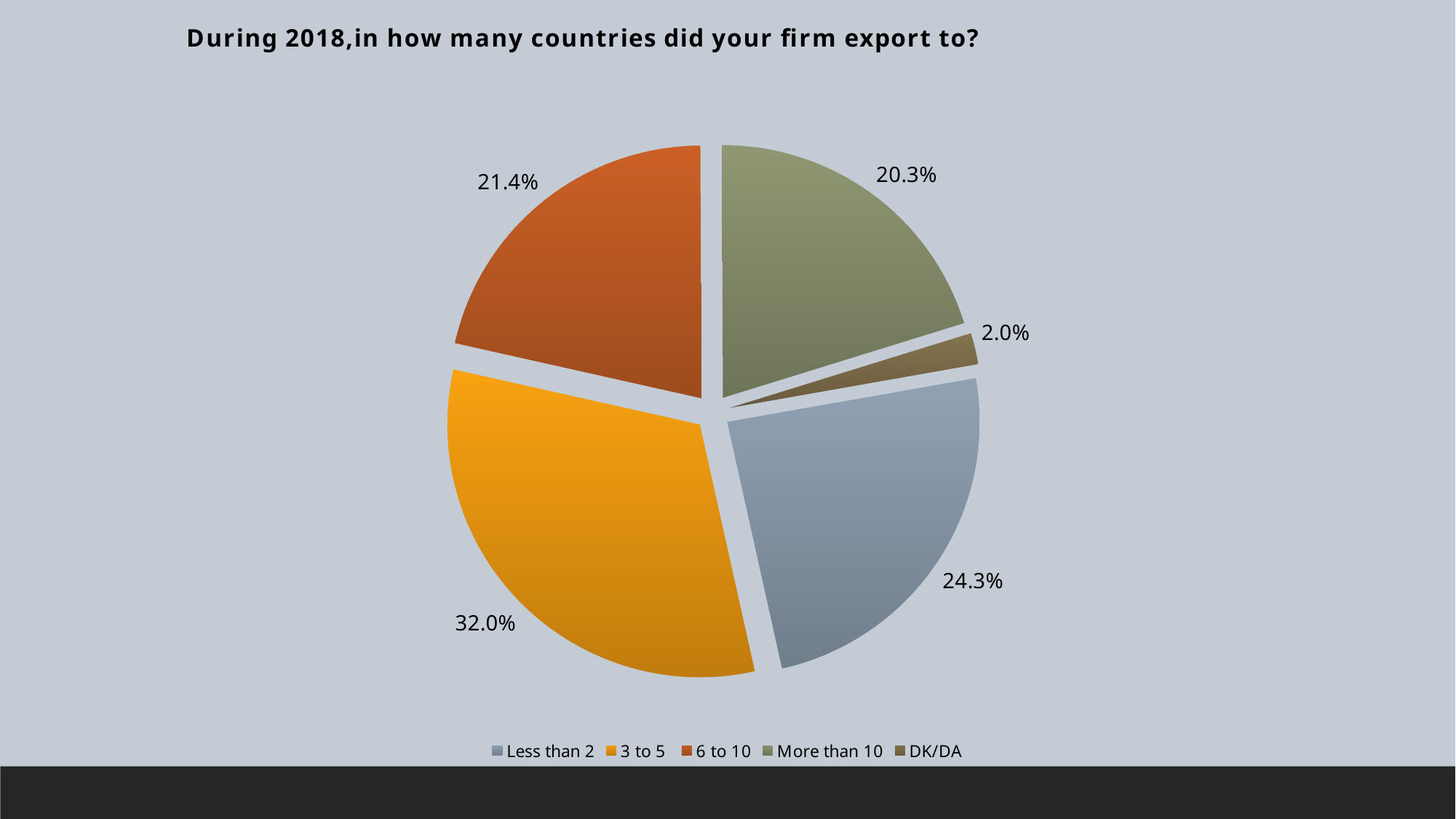
What share of firms exported to less than 2 countries? 24.3% What type of chart is shown on the slide? Pie chart What share of firms exported to more than 10 countries? 20.3% Which category has the smallest share of the pie? DK/DA Which category has the largest share of the pie? 3 to 5 What share of firms exported to 3 to 5 countries? 32.0% What is the difference in percentage points between the '3 to 5' and 'Less than 2' shares? 7.7 How many categories does the pie chart show? 5 What share of firms exported to 6 to 10 countries? 21.4% Which is larger, the share for '6 to 10' or the share for 'More than 10'? 6 to 10 What is the title of the chart? During 2018,in how many countries did your firm export to? What share of responses were DK/DA? 2.0%